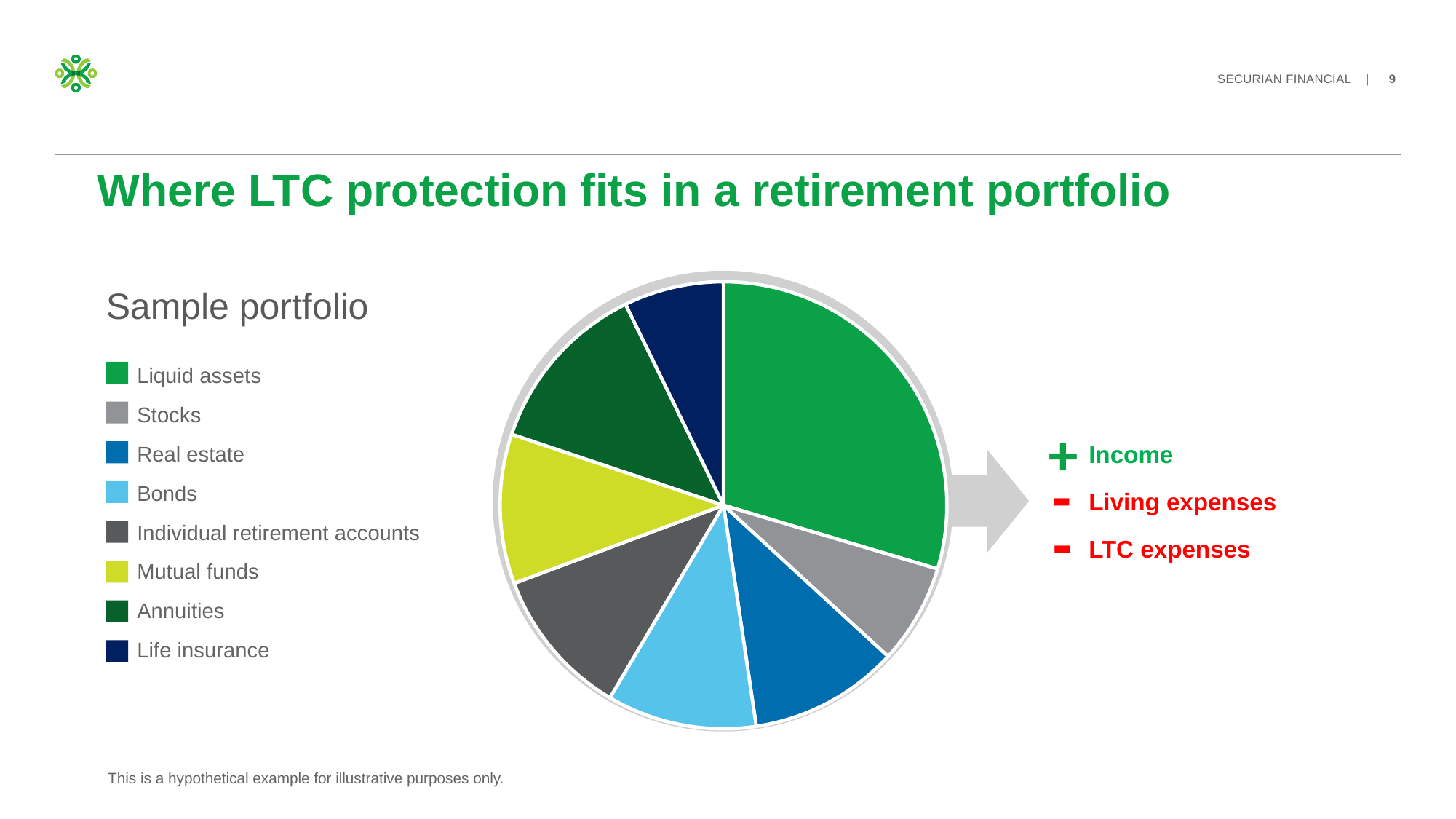
Which category has the largest slice in the pie chart? Liquid assets How many slices does the pie chart have? 8 Which slice is larger in the pie chart, Annuities or Stocks? Annuities Which category in the pie chart is shown in light blue? Bonds What kind of chart is shown on the slide? Pie chart Which slice is larger in the pie chart, Liquid assets or Stocks? Liquid assets Which slice is larger in the pie chart, Mutual funds or Life insurance? Mutual funds What is the title shown above the legend of the pie chart? Sample portfolio How many categories does the legend of the pie chart list? 8